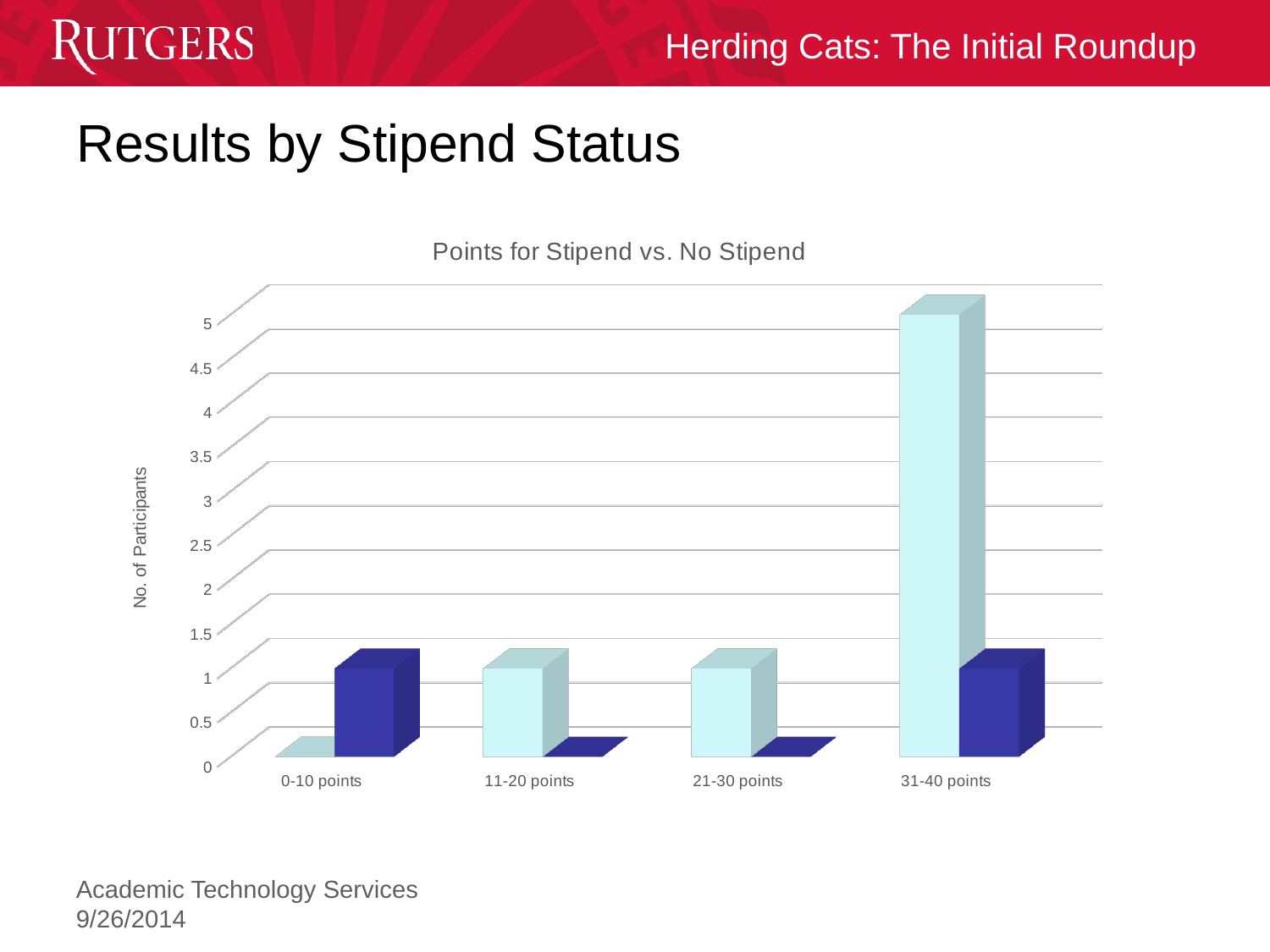
What is the title of the chart? Points for Stipend vs. No Stipend Is the value of the light blue bar for 31-40 points greater or less than 4? greater What is the difference between the light blue bar for 31-40 points and the light blue bar for 21-30 points? 4 Which category has the tallest light blue bar? 31-40 points Is the value of the dark blue bar for 31-40 points greater or less than 2? less What is the value of the light blue bar for 11-20 points? 1 What is the value of the light blue bar for 31-40 points? 5 How many point-range categories are shown on the x axis? 4 What is the label on the vertical axis of the chart? No. of Participants What is the value of the dark blue bar for 0-10 points? 1 For 31-40 points, which bar is taller, the light blue bar or the dark blue bar? light blue bar What kind of chart is shown on the slide? bar chart